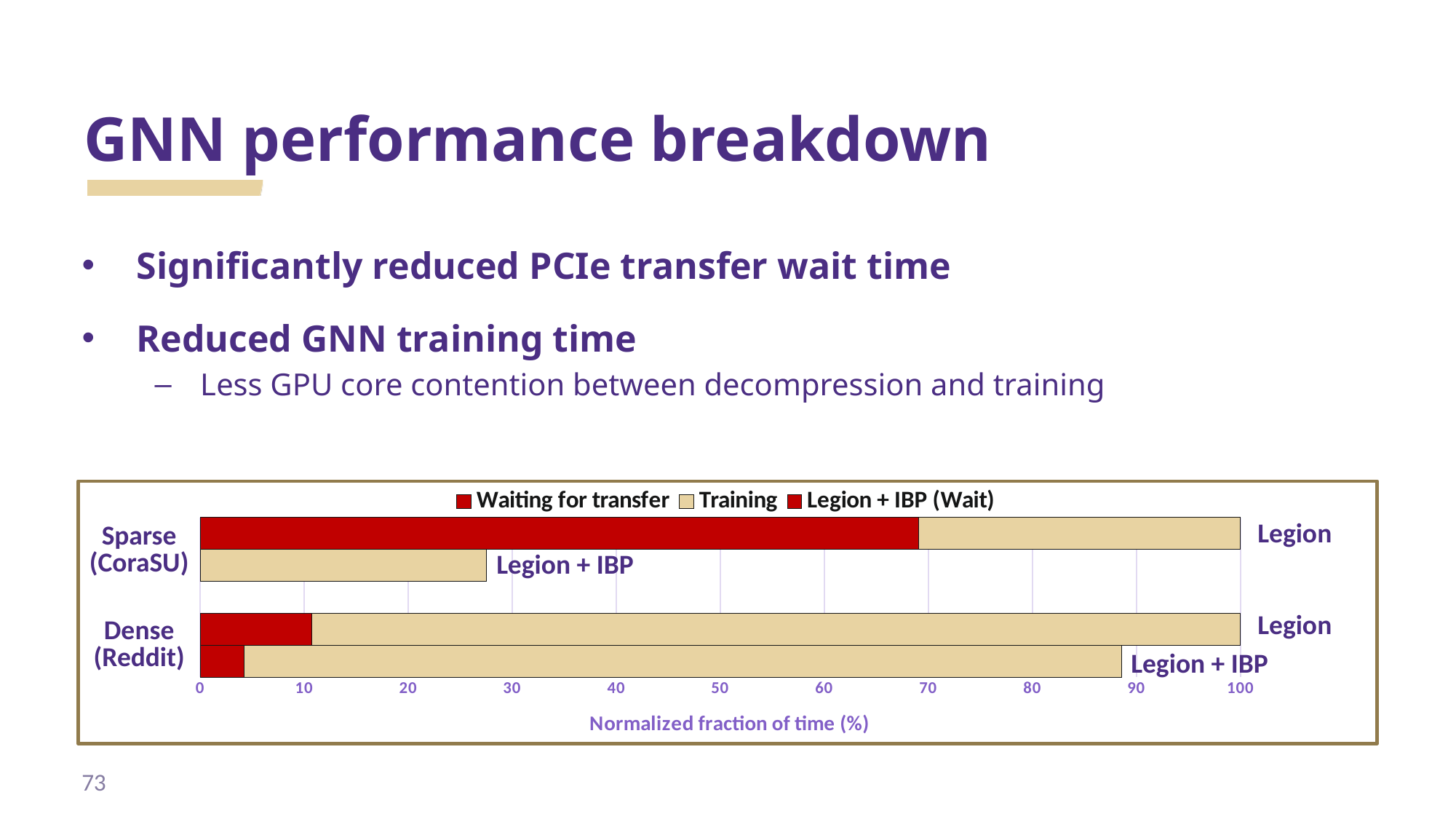
Which legend entry is shown with the tan (beige) colour in the chart? Training How many series does the chart legend list? 3 What kind of chart is shown on the slide? bar chart How many dataset categories are labelled on the vertical axis of the chart? 2 Is the waiting portion of the Legion + IBP bar for Dense (Reddit) greater or less than 10? less For Sparse (CoraSU), which bar is longer overall: Legion or Legion + IBP? Legion Is the 'Waiting for transfer' portion of the Legion bar for Sparse (CoraSU) greater or less than 60? greater Which has a larger 'Waiting for transfer' portion in its Legion bar: Sparse (CoraSU) or Dense (Reddit)? Sparse (CoraSU) Is the total length of the Legion + IBP bar for Dense (Reddit) greater or less than 80? greater What is the highest value shown on the horizontal axis of the chart? 100 What is the title of the horizontal axis of the chart? Normalized fraction of time (%)